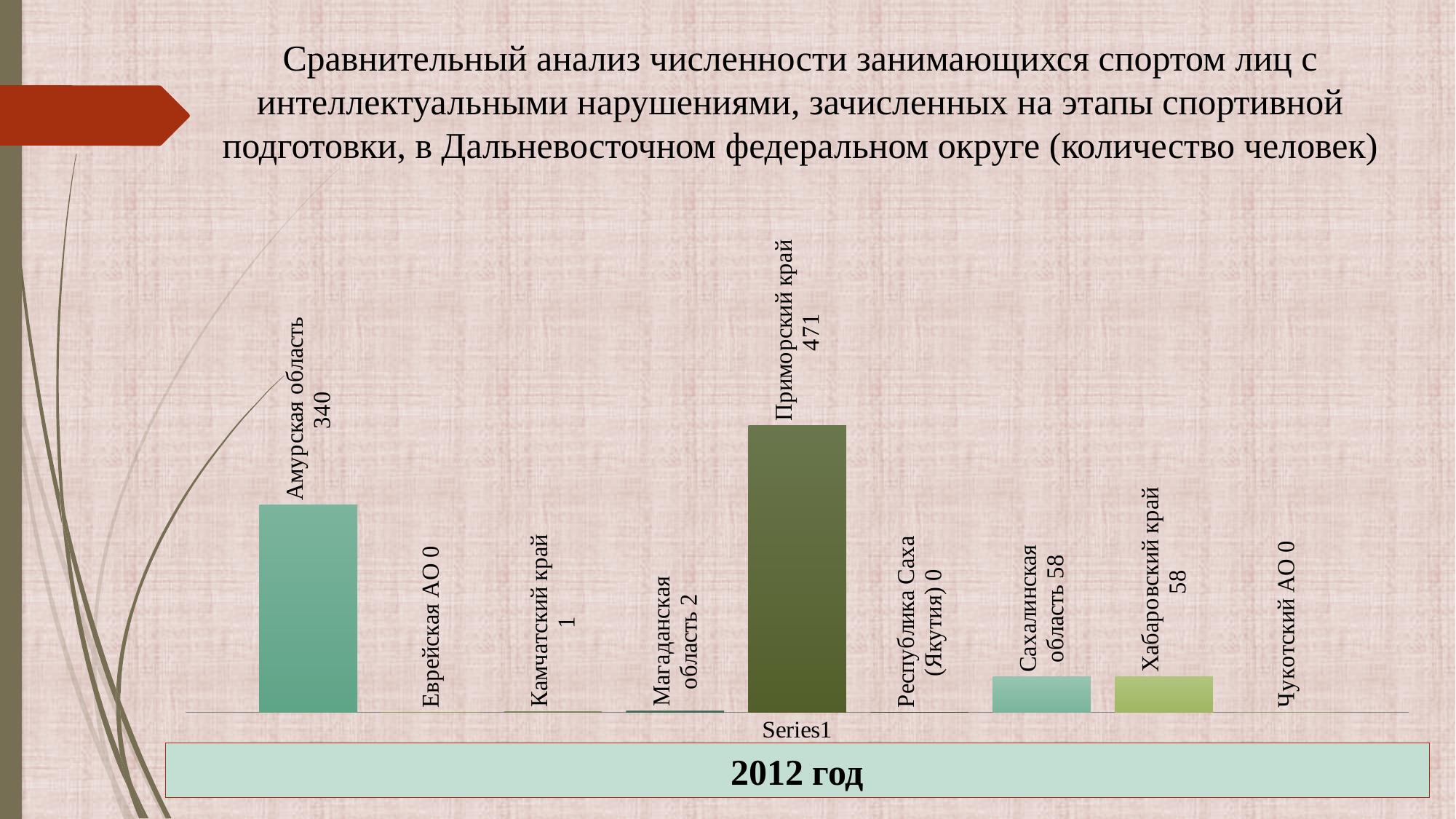
Which region has the highest value? Приморский край What is the value for Магаданская область? 2 What is the value for Камчатский край? 1 What is the value for Сахалинская область? 58 What is the value for Амурская область? 340 Which is larger, the value for Амурская область or the value for Хабаровский край? Амурская область What is the difference between the values for Приморский край and Амурская область? 131 What kind of chart is shown on the slide? bar chart How many regions have a value of 0? 3 What is the value for Приморский край? 471 How many regions are shown in the chart? 9 Which year does the chart refer to, according to the label below it? 2012 год